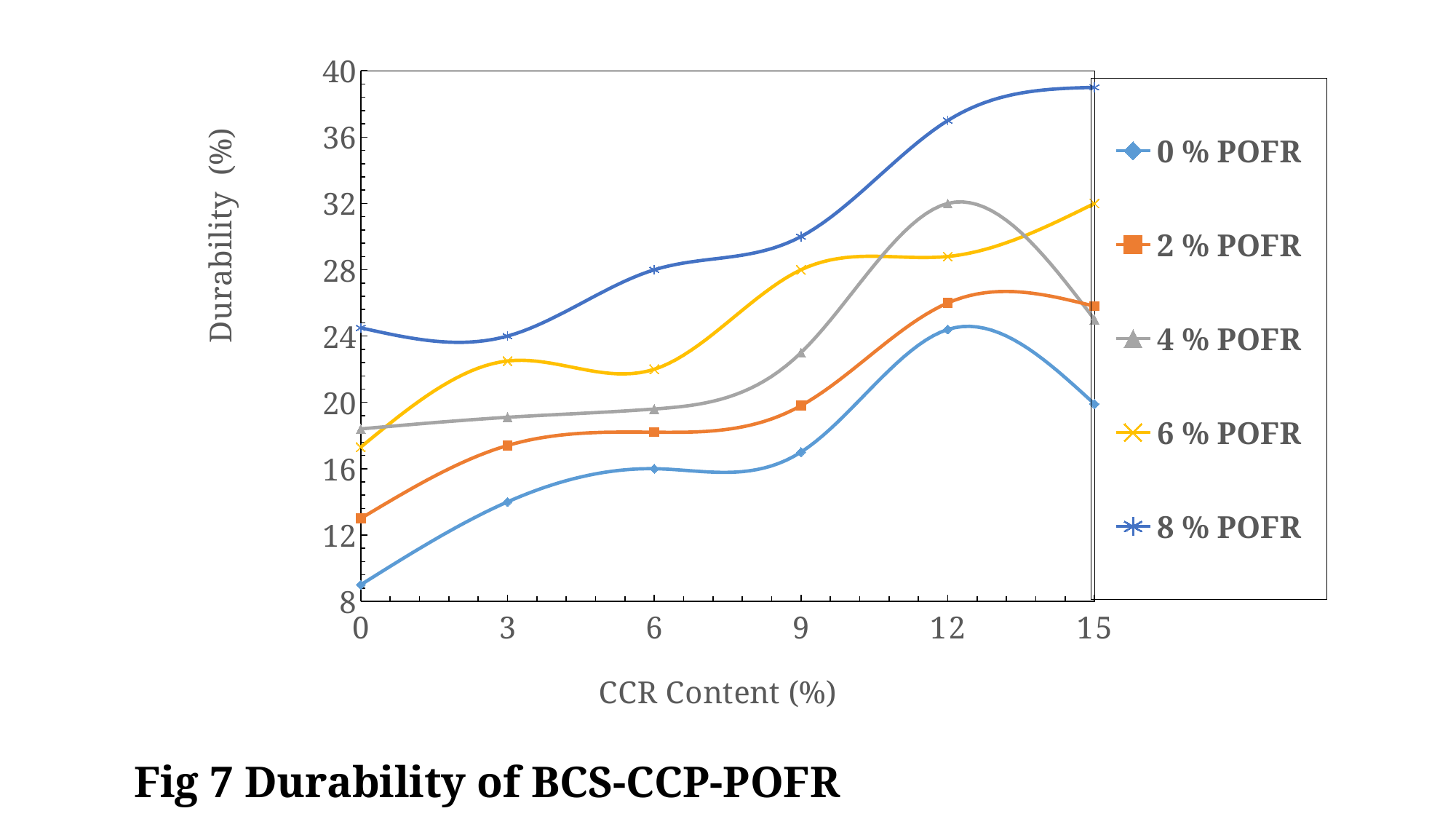
What is the label of the y axis? Durability (%) How many series does the legend list? 5 Is the durability for 0 % POFR at 0% CCR content greater or less than 12? less Which series has the highest durability at 15% CCR content? 8 % POFR Does the durability for 8 % POFR generally rise or fall as CCR content increases from 3% to 15%? rise Is the durability for 2 % POFR at 12% CCR content greater or less than 24? greater What is the caption given for the chart? Fig 7 Durability of BCS-CCP-POFR Is the durability for 8 % POFR at 15% CCR content greater or less than 36? greater Which series has the lowest durability at 0% CCR content? 0 % POFR At 12% CCR content, which is larger: the durability for 4 % POFR or for 6 % POFR? 4 % POFR How many CCR content points are plotted along the x axis for each series? 6 What kind of chart is shown on the slide? line chart